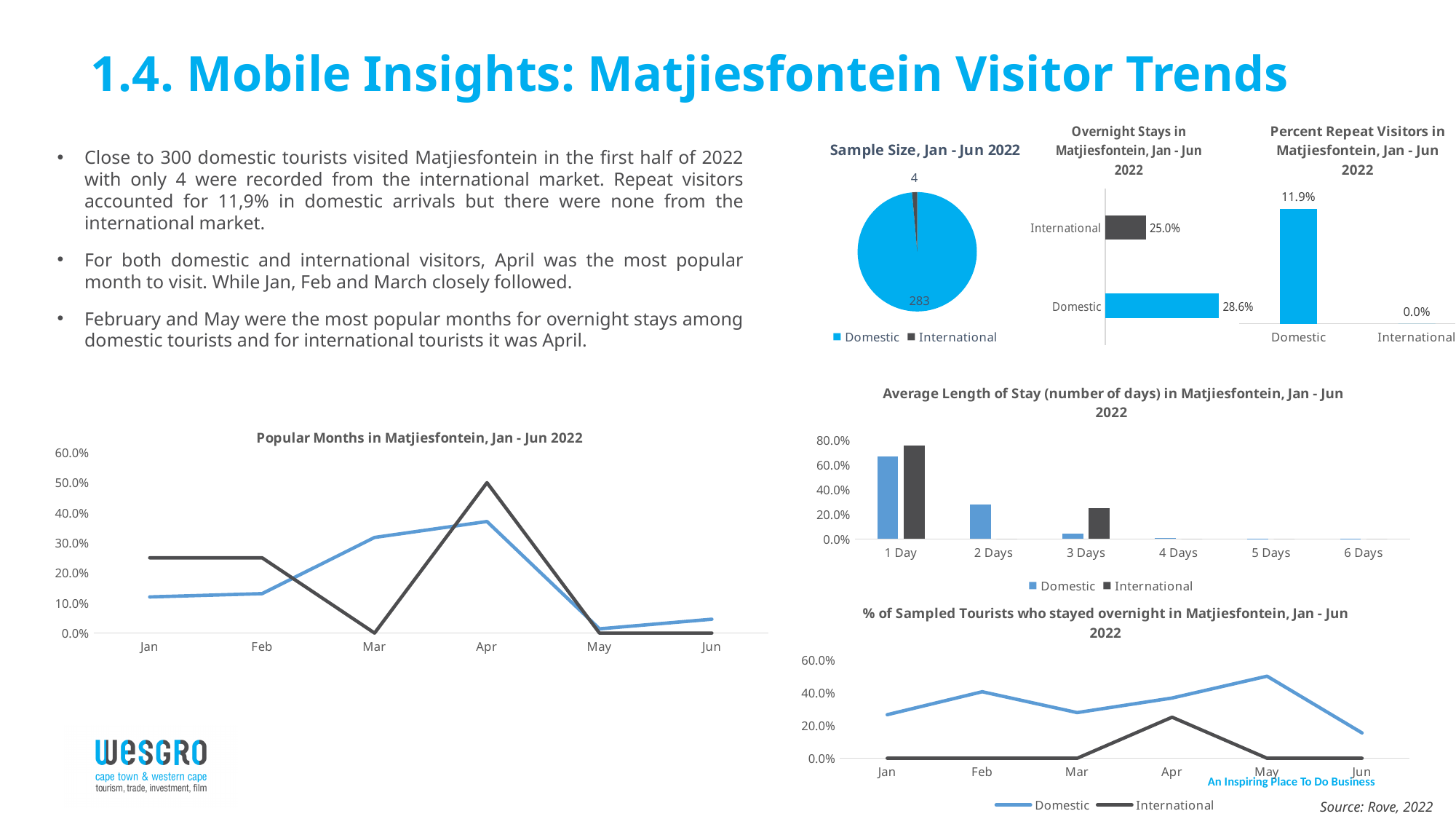
In the Average Length of Stay chart, is the Domestic value for 1 Day greater or less than 60.0%? greater In the Percent Repeat Visitors in Matjiesfontein chart, what is the value for Domestic? 11.9% In the Overnight Stays in Matjiesfontein chart, what is the value for Domestic? 28.6% In the Sample Size, Jan - Jun 2022 pie chart, what is the value for Domestic? 283 In the % of Sampled Tourists who stayed overnight chart, in which month does the Domestic line reach its highest value? May In the Average Length of Stay chart, which series has the larger value for 3 Days, Domestic or International? International In the Overnight Stays in Matjiesfontein chart, what is the value for International? 25.0% How many months are shown on the x axis of the Popular Months in Matjiesfontein chart? 6 In the Overnight Stays in Matjiesfontein chart, what is the difference between the Domestic and International values? 3.6% In the Percent Repeat Visitors in Matjiesfontein chart, which category has the lower value? International In the Sample Size, Jan - Jun 2022 pie chart, what is the value for International? 4 What kind of chart is the Popular Months in Matjiesfontein, Jan - Jun 2022 chart? line chart